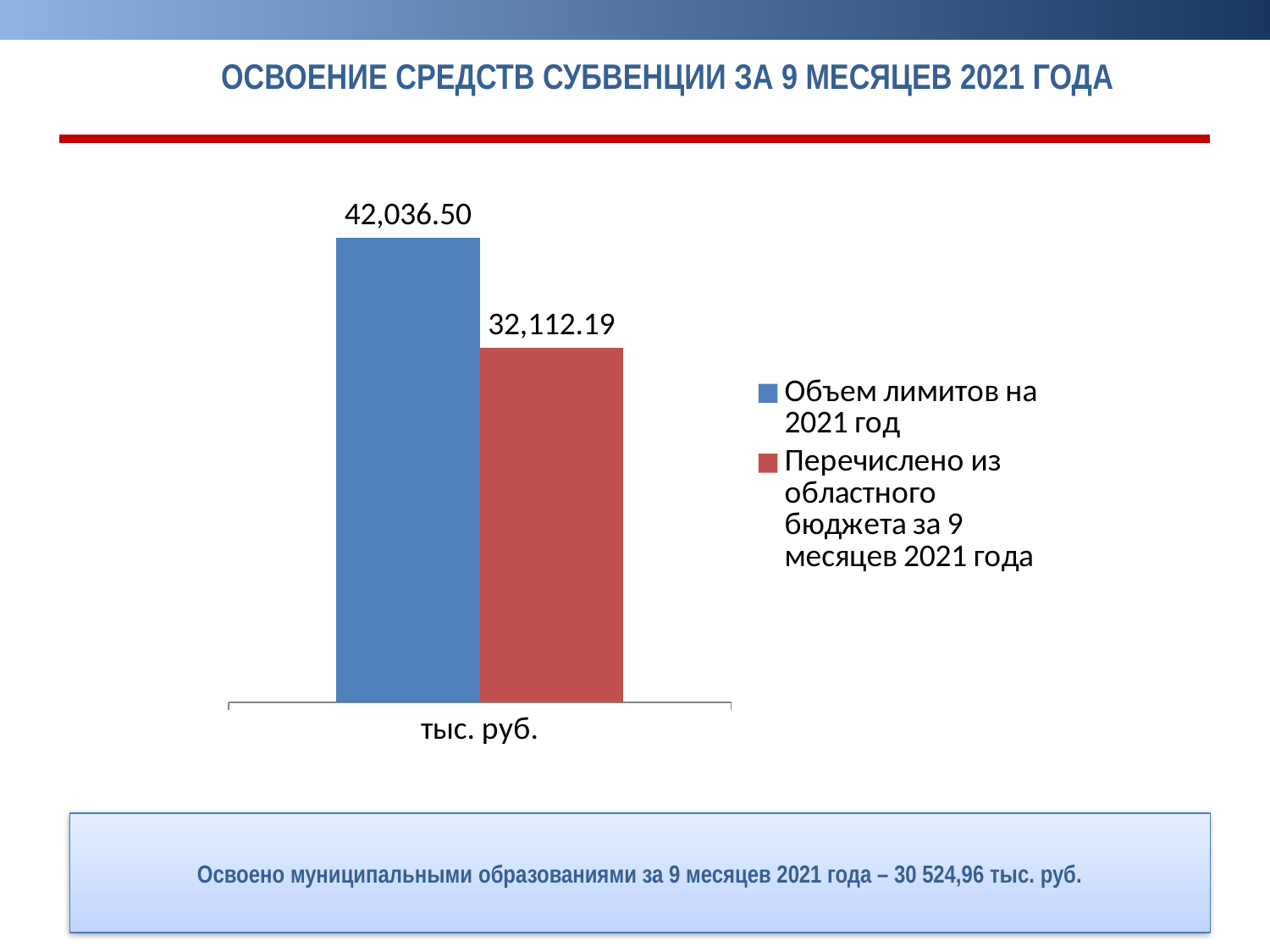
What is the label shown on the category axis of the chart? тыс. руб. What colour is the bar for "Перечислено из областного бюджета за 9 месяцев 2021 года"? red How many bars are plotted in the chart? 2 What is the value of the bar for "Объем лимитов на 2021 год"? 42,036.50 Which series has the higher value in the chart? Объем лимитов на 2021 год Is the value for "Объем лимитов на 2021 год" larger or smaller than the value for "Перечислено из областного бюджета за 9 месяцев 2021 года"? larger What is the difference between the value for "Объем лимитов на 2021 год" and the value for "Перечислено из областного бюджета за 9 месяцев 2021 года"? 9,924.31 What is the value of the bar for "Перечислено из областного бюджета за 9 месяцев 2021 года"? 32,112.19 How many series does the legend list? 2 What kind of chart is shown on the slide? bar chart Which series has the lower value in the chart? Перечислено из областного бюджета за 9 месяцев 2021 года